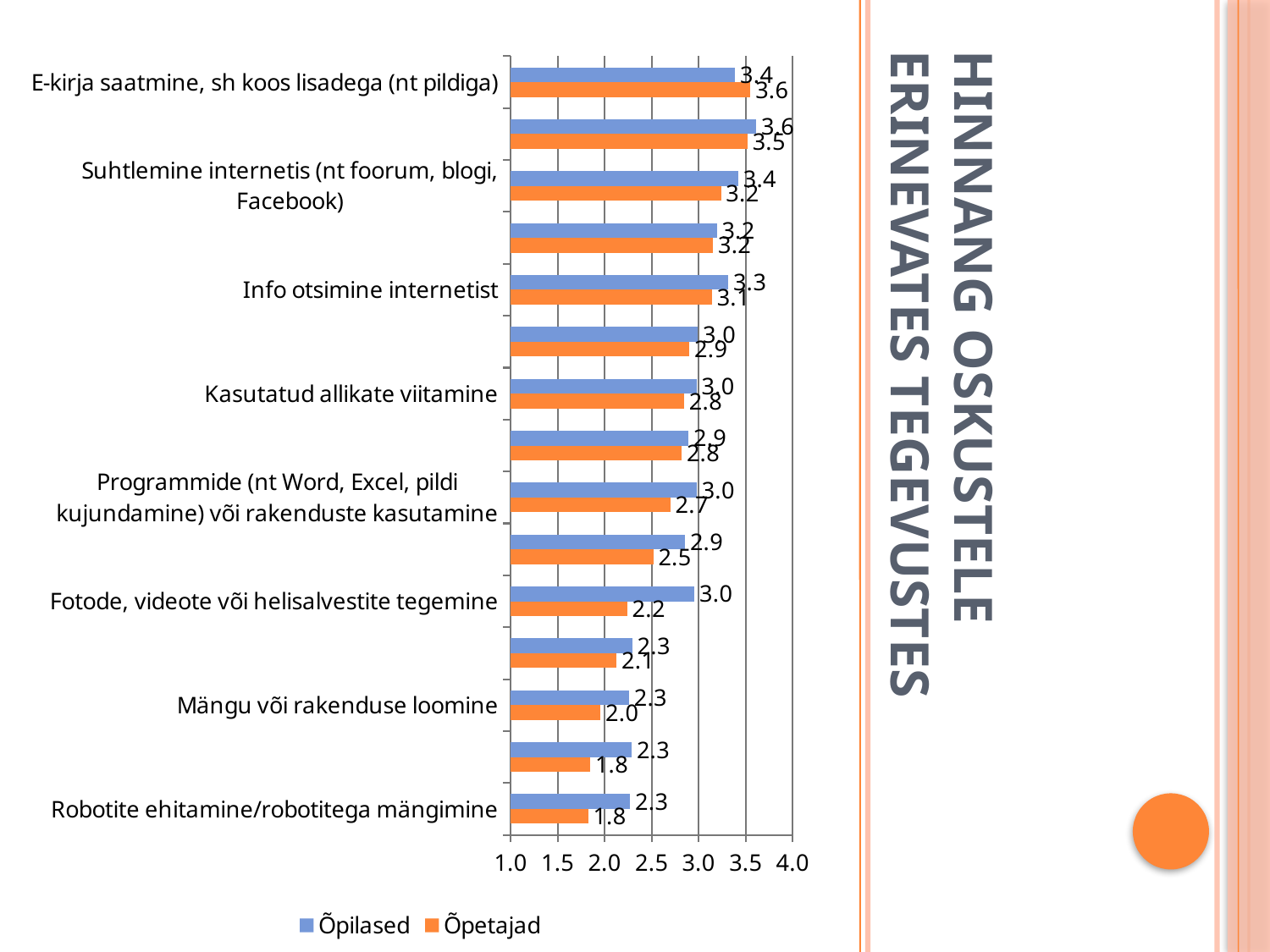
What type of chart is shown on the slide? Bar chart What is the Õpetajad value for "Fotode, videote või helisalvestite tegemine"? 2.2 Which category has the highest Õpetajad value? E-kirja saatmine, sh koos lisadega (nt pildiga) For "Info otsimine internetist", which series has the larger value, Õpilased or Õpetajad? Õpilased What is the difference between the Õpilased and Õpetajad values for "Fotode, videote või helisalvestite tegemine"? 0.8 How many series does the legend list? 2 What is the Õpetajad value for "E-kirja saatmine, sh koos lisadega (nt pildiga)"? 3.6 What is the Õpetajad value for "Programmide (nt Word, Excel, pildi kujundamine) või rakenduste kasutamine"? 2.7 What is the difference between the Õpilased and Õpetajad values for "Mängu või rakenduse loomine"? 0.3 For "E-kirja saatmine, sh koos lisadega (nt pildiga)", which series has the larger value, Õpilased or Õpetajad? Õpetajad What is the Õpilased value for "E-kirja saatmine, sh koos lisadega (nt pildiga)"? 3.4 What is the Õpetajad value for "Robotite ehitamine/robotitega mängimine"? 1.8